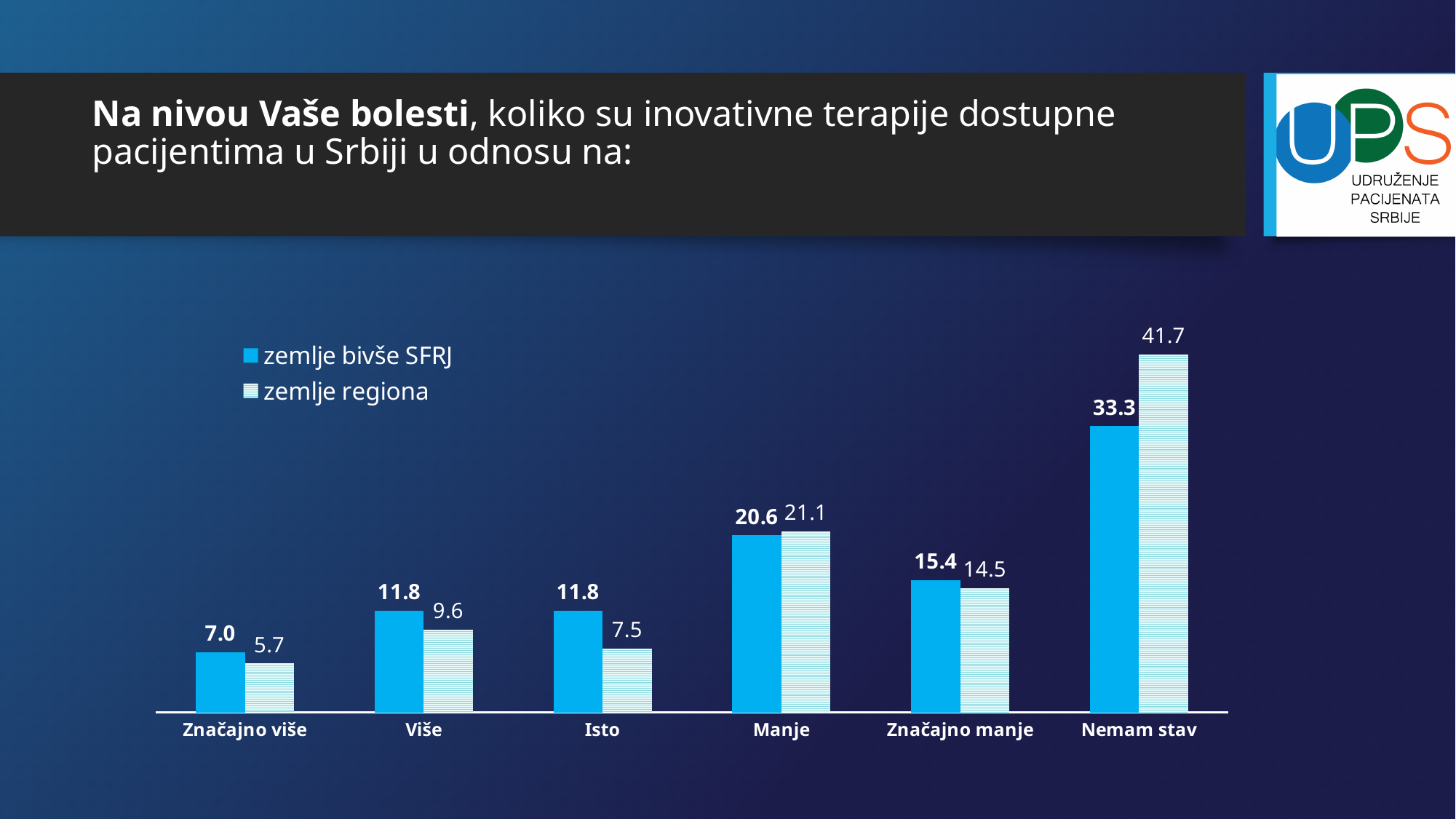
What is the difference between the 'zemlje bivše SFRJ' and 'zemlje regiona' values for 'Isto'? 4.3 What is the difference between the 'zemlje regiona' and 'zemlje bivše SFRJ' values for 'Nemam stav'? 8.4 What is the value for 'Manje' in the 'zemlje bivše SFRJ' series? 20.6 Which series is shown with solid blue bars? zemlje bivše SFRJ What kind of chart is shown on the slide? Bar chart For 'Više', which series has the larger value: 'zemlje bivše SFRJ' or 'zemlje regiona'? zemlje bivše SFRJ Which category has the highest value in the 'zemlje bivše SFRJ' series? Nemam stav What is the value for 'Nemam stav' in the 'zemlje regiona' series? 41.7 What is the value for 'Značajno više' in the 'zemlje regiona' series? 5.7 How many categories are shown on the x axis? 6 Which category has the lowest value in the 'zemlje regiona' series? Značajno više How many series does the legend list? 2